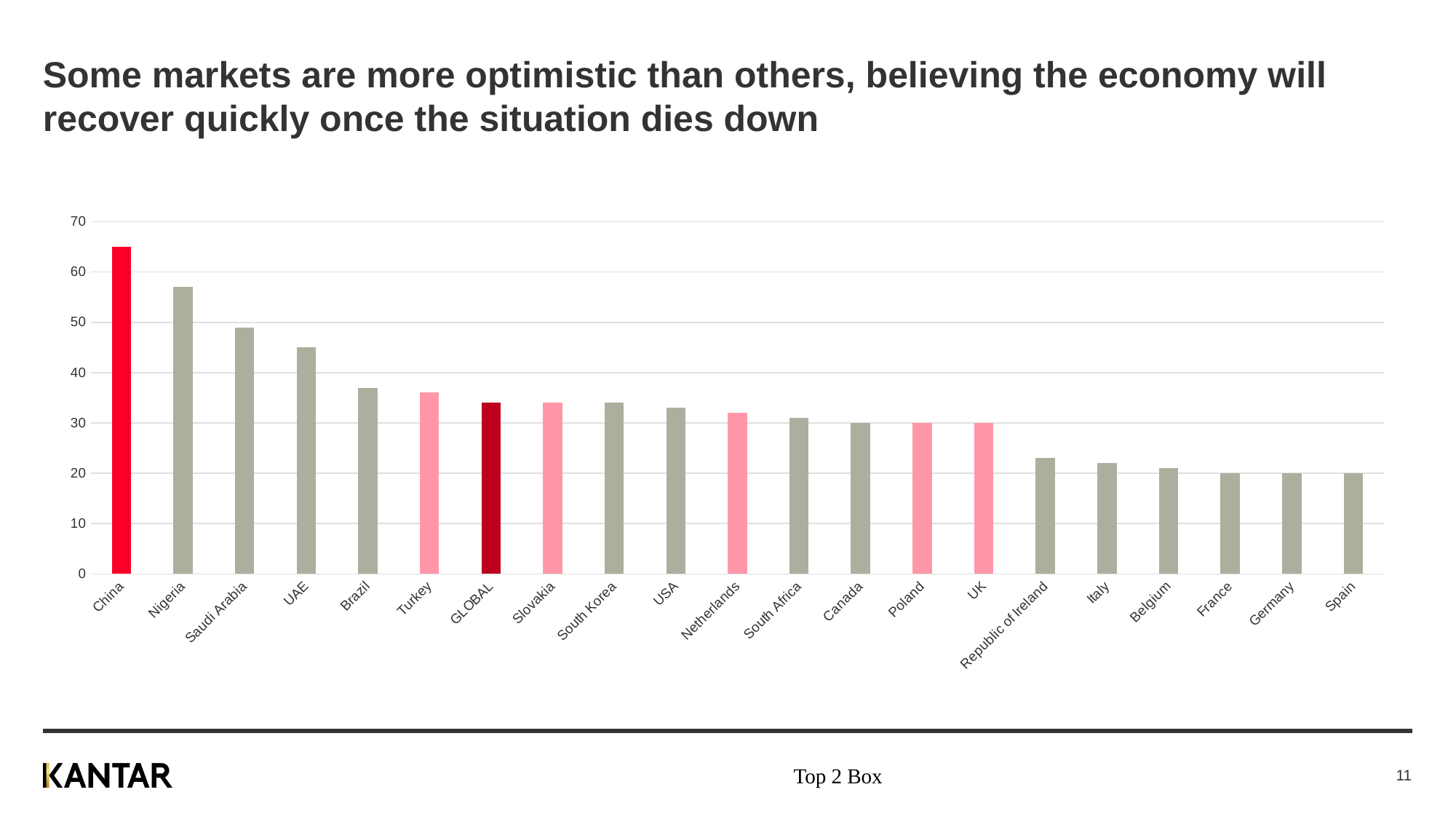
Which is larger, the value for UAE or the value for Brazil? UAE Is the value for Nigeria greater or less than 50? greater Which is larger, the value for Netherlands or the value for Republic of Ireland? Netherlands Do the values generally rise or fall moving from left to right along the x axis? fall Which market has the highest value in the chart? China How many categories are plotted along the x axis? 21 Is the value for Brazil greater or less than 40? less What kind of chart is shown on the slide? bar chart What colour is the bar for China? red Is the value for Republic of Ireland greater or less than 30? less